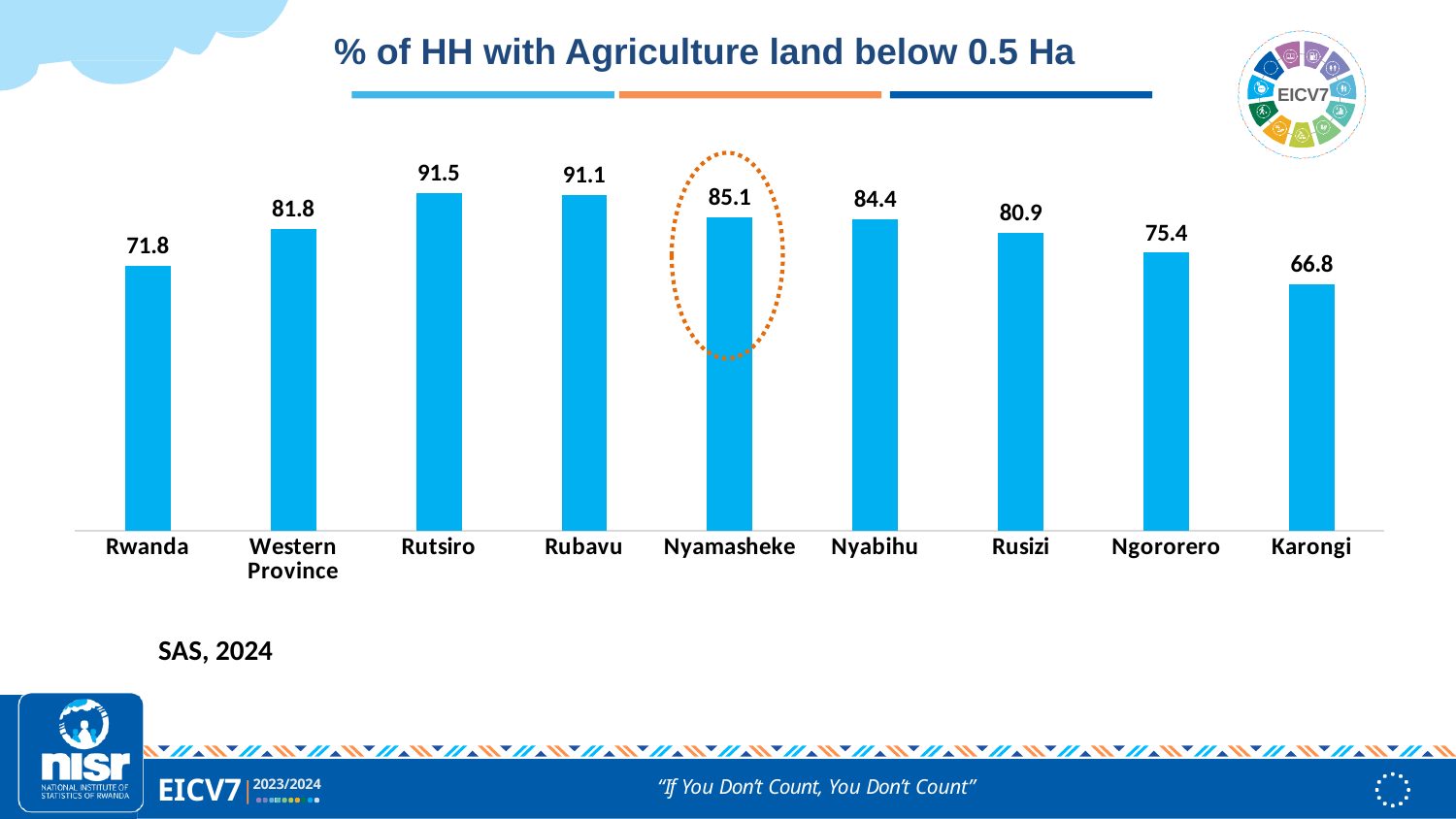
Which category has the lowest value? Karongi How many categories are shown on the x axis? 9 Which category has the highest value? Rutsiro Which is larger, the value for Nyabihu or the value for Rusizi? Nyabihu What is the difference between the values for Nyamasheke and Rwanda? 13.3 What kind of chart is shown on the slide? bar chart What is the value for Rwanda? 71.8 What is the difference between the values for Rutsiro and Karongi? 24.7 What is the value for Western Province? 81.8 Which is larger, the value for Ngororero or the value for Western Province? Western Province What is the title of the chart? % of HH with Agriculture land below 0.5 Ha What is the value for Nyamasheke? 85.1